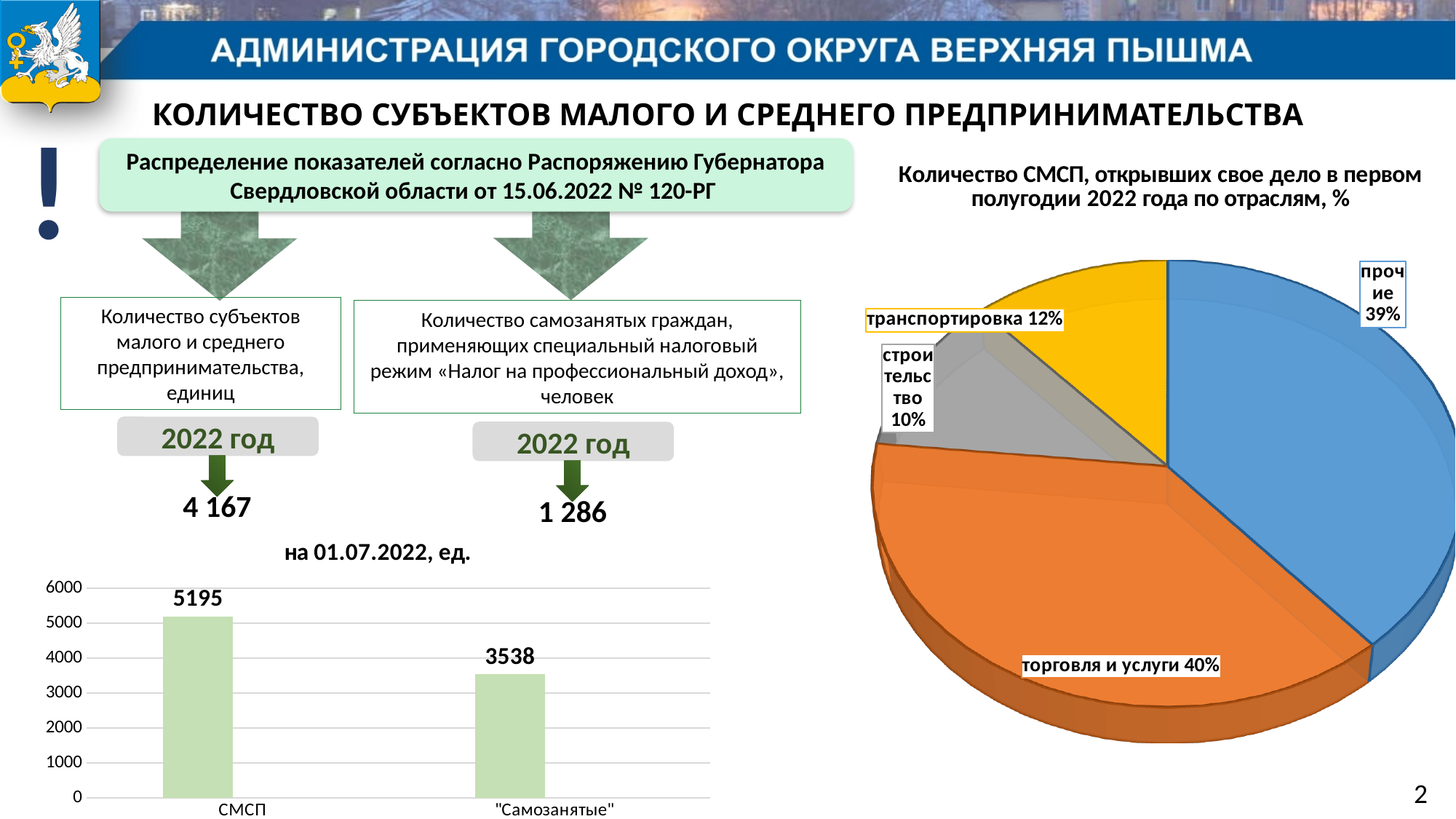
In the pie chart on the right, which sector has the smallest share? строительство What kind of chart is the chart on the right side of the slide? pie chart In the bar chart titled "на 01.07.2022, ед.", what is the value for "Самозанятые"? 3538 In the bar chart titled "на 01.07.2022, ед.", what is the value for СМСП? 5195 What kind of chart is the chart titled "на 01.07.2022, ед."? bar chart In the bar chart titled "на 01.07.2022, ед.", how many categories are shown? 2 In the pie chart on the right, what share does торговля и услуги have? 40% In the bar chart titled "на 01.07.2022, ед.", is the value for "Самозанятые" greater or less than 4000? less In the pie chart on the right, how many slices are there? 4 In the bar chart titled "на 01.07.2022, ед.", what is the difference between the СМСП value and the "Самозанятые" value? 1657 In the pie chart on the right, what share does транспортировка have? 12% In the bar chart titled "на 01.07.2022, ед.", which category has the higher value? СМСП